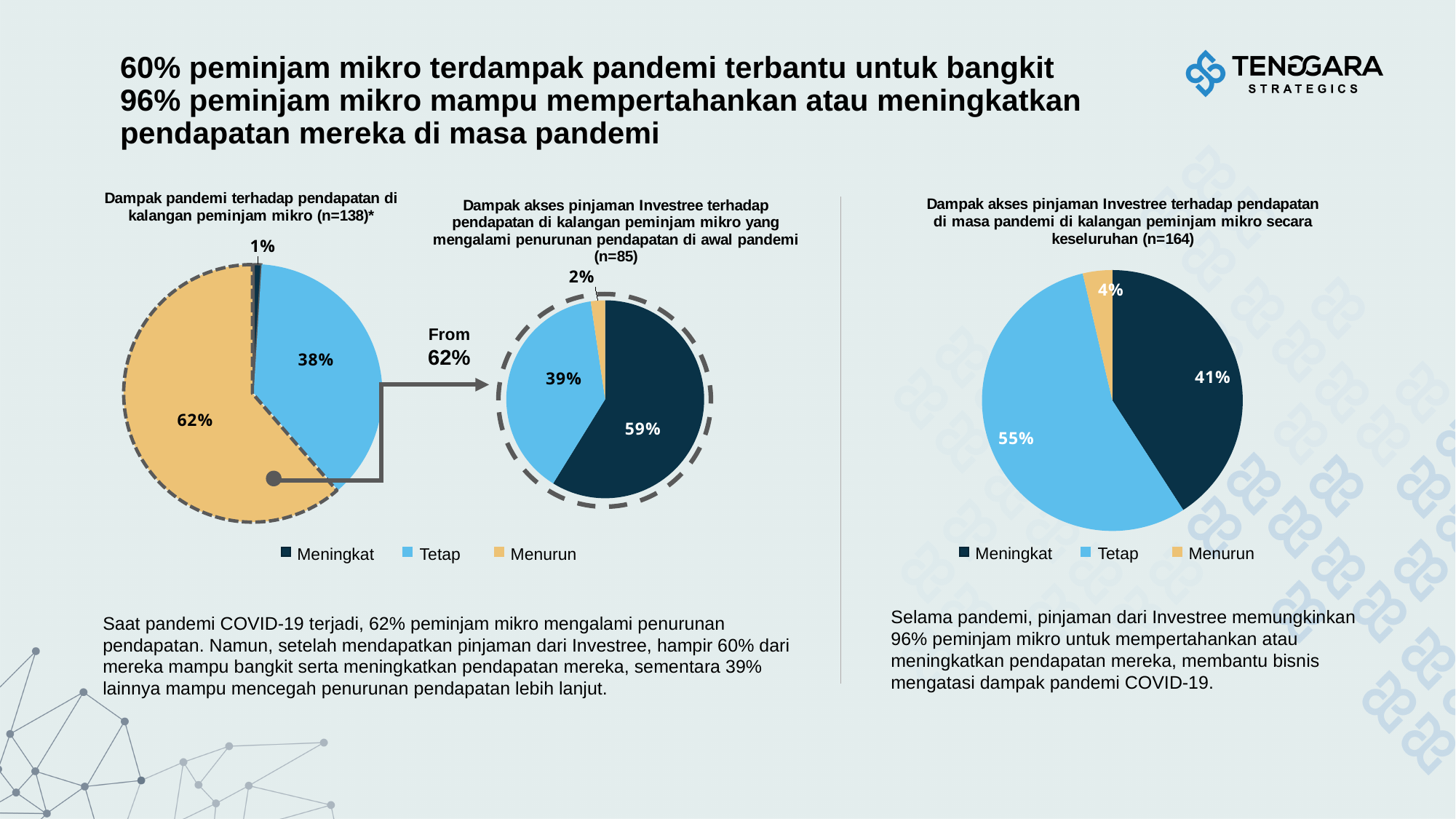
In the middle pie chart (n=85), what share of borrowers reported Meningkat? 59% In the right pie chart (n=164), which is larger, Meningkat or Tetap? Tetap What type of chart is used for the three charts on this slide? Pie chart In the left pie chart (n=138), what share of micro borrowers reported Menurun (decreased income)? 62% In the left pie chart (n=138), which category has the smallest share? Meningkat How many categories does the legend of the right pie chart list? 3 In the middle pie chart (n=85), what is the difference between the Meningkat and Tetap shares? 20% In the middle pie chart (n=85), what share of borrowers reported Menurun? 2% In the left pie chart (n=138), what share of micro borrowers reported Tetap? 38% In the right pie chart (n=164), what share of borrowers reported Tetap? 55% In the middle pie chart (n=85), which category has the largest share? Meningkat In the right pie chart (n=164), what is the combined share of Meningkat and Tetap? 96%